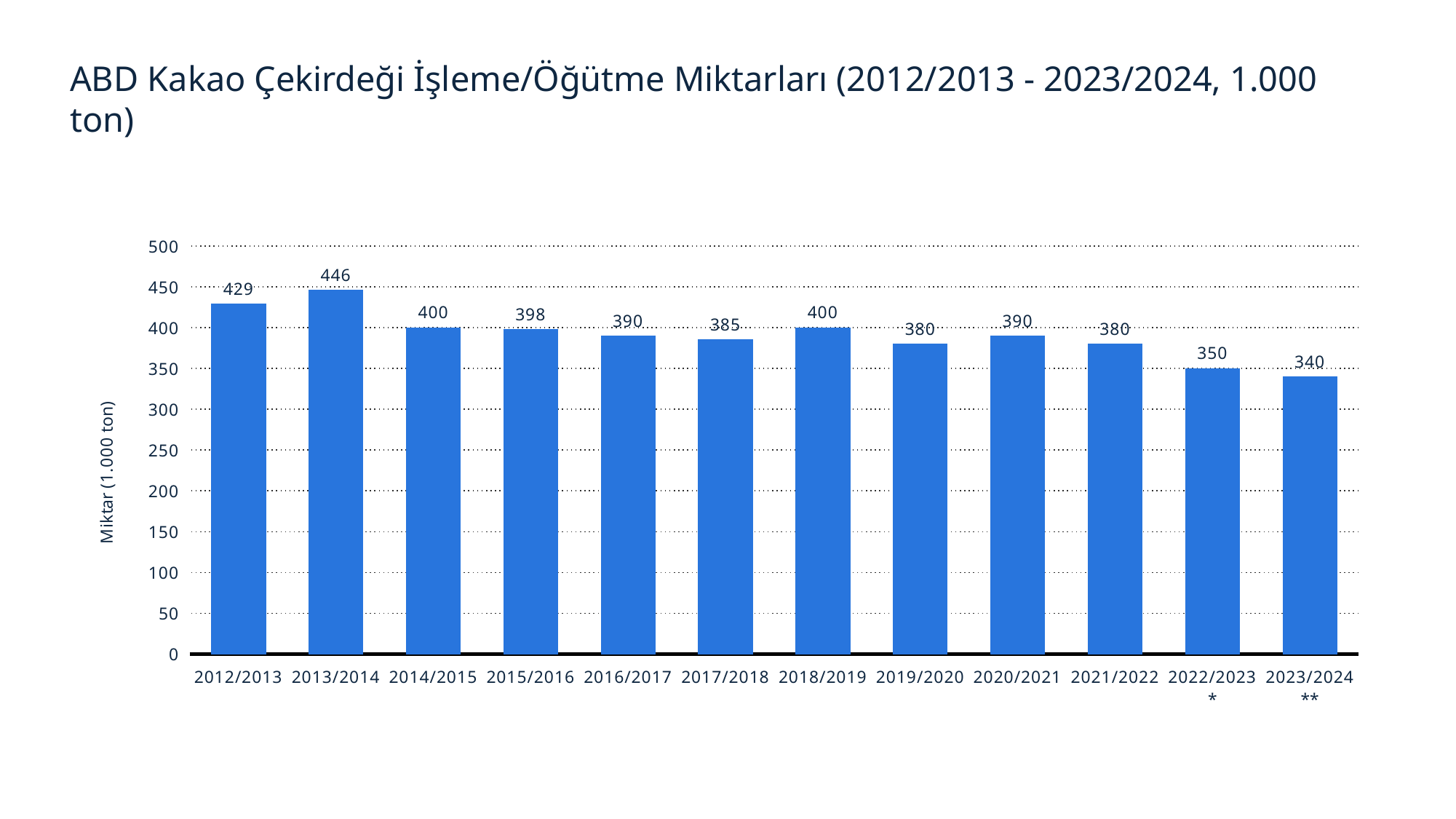
Which season has the highest value? 2013/2014 How many seasons are shown on the x axis? 12 What is the value for 2023/2024? 340 What is the difference between the values for 2022/2023 and 2023/2024? 10 Which is larger, the value for 2015/2016 or the value for 2016/2017? 2015/2016 What kind of chart is shown on the slide? bar chart What is the value for 2013/2014? 446 What is the value for 2017/2018? 385 What is the difference between the values for 2013/2014 and 2012/2013? 17 Is the value for 2012/2013 greater or less than 400? greater Which season has the lowest value? 2023/2024 What is the label of the y axis? Miktar (1.000 ton)